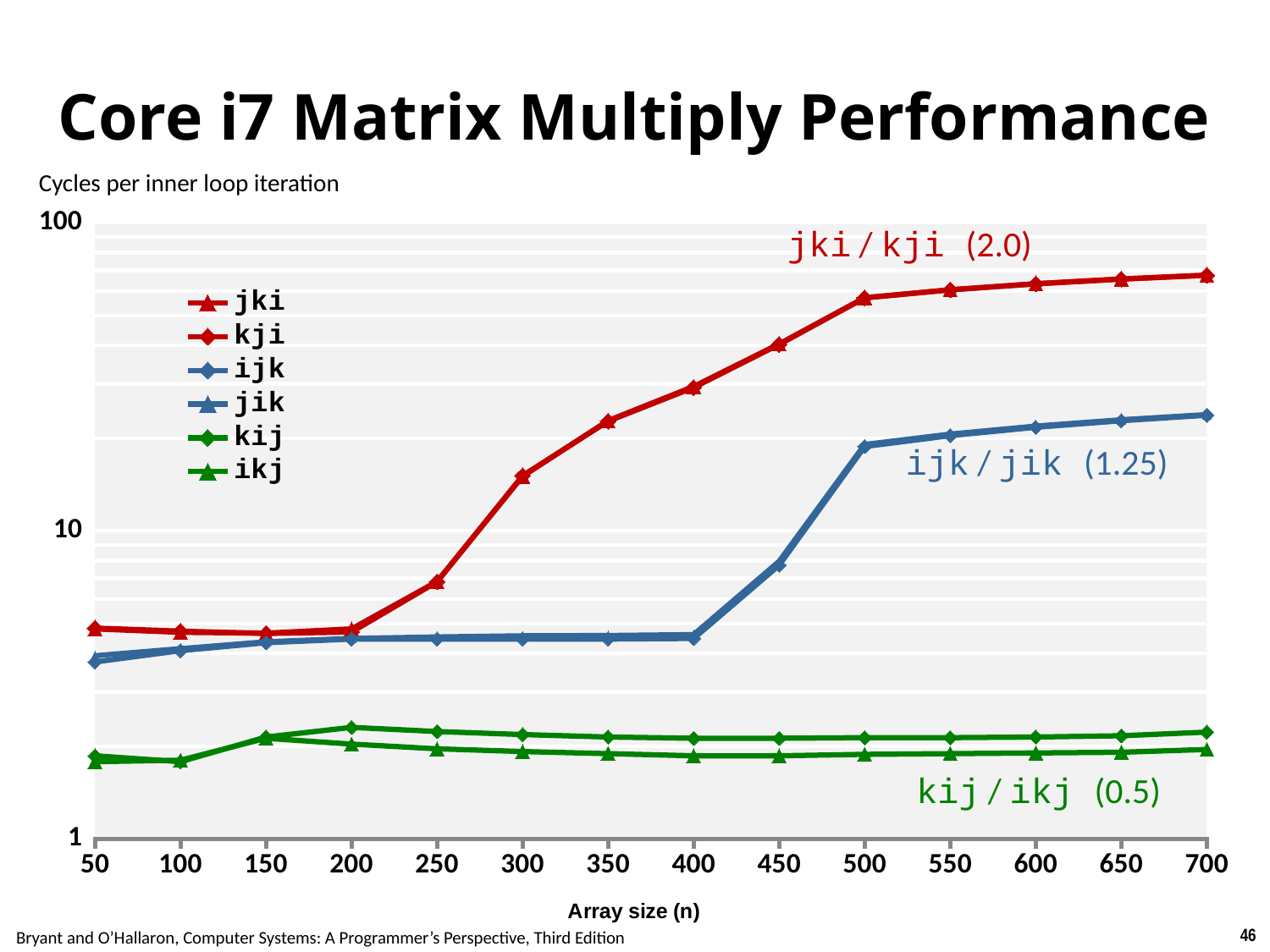
Is the value for kij at array size 700 greater or less than 10? less How many array size values are plotted along the x axis? 14 Is the value for ijk at array size 600 greater or less than 10? greater Do the values for the jki series rise or fall as array size increases from 200 to 700? rise How many series does the legend list? 6 What kind of chart is shown on the slide? line chart What is the title of the chart? Core i7 Matrix Multiply Performance Is the value for jki at array size 700 greater or less than 10? greater At array size 300, which is larger: the value for kji or the value for jik? kji At array size 700, which is larger: the value for jki or the value for kij? jki What is the label of the x axis? Array size (n)